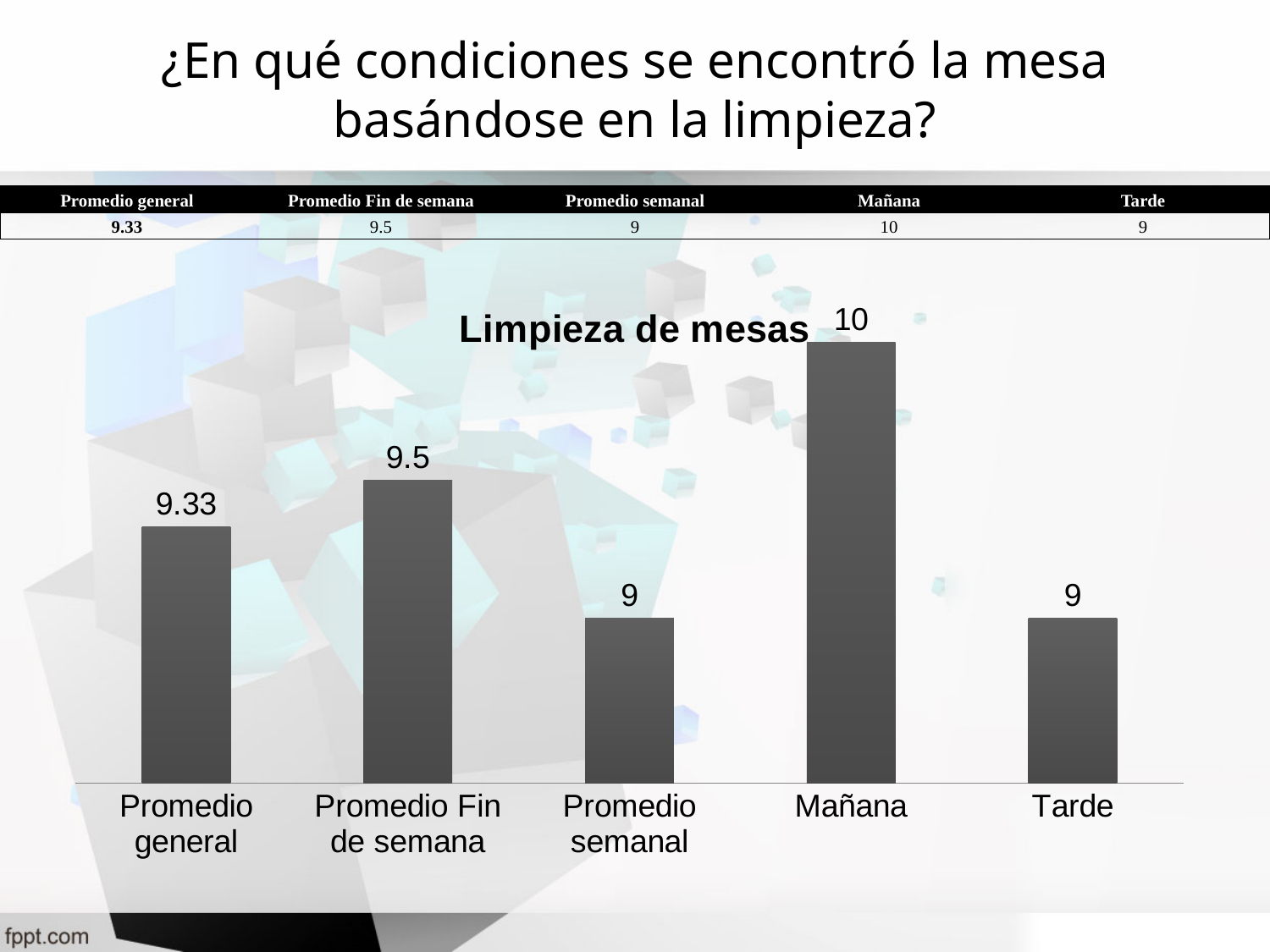
What is the value for Tarde? 9 What is the value for Mañana? 10 What is the title of the chart? Limpieza de mesas What is the difference between the values for Promedio Fin de semana and Promedio semanal? 0.5 What kind of chart is shown on the slide? Bar chart What is the value for Promedio Fin de semana? 9.5 Which is larger, the value for Promedio general or the value for Promedio semanal? Promedio general How many categories are shown in the chart? 5 Which category has the highest value in the chart? Mañana What is the value for Promedio general in the Limpieza de mesas chart? 9.33 Do the values for Promedio semanal and Tarde have the same value? Yes What is the difference between the values for Mañana and Tarde? 1